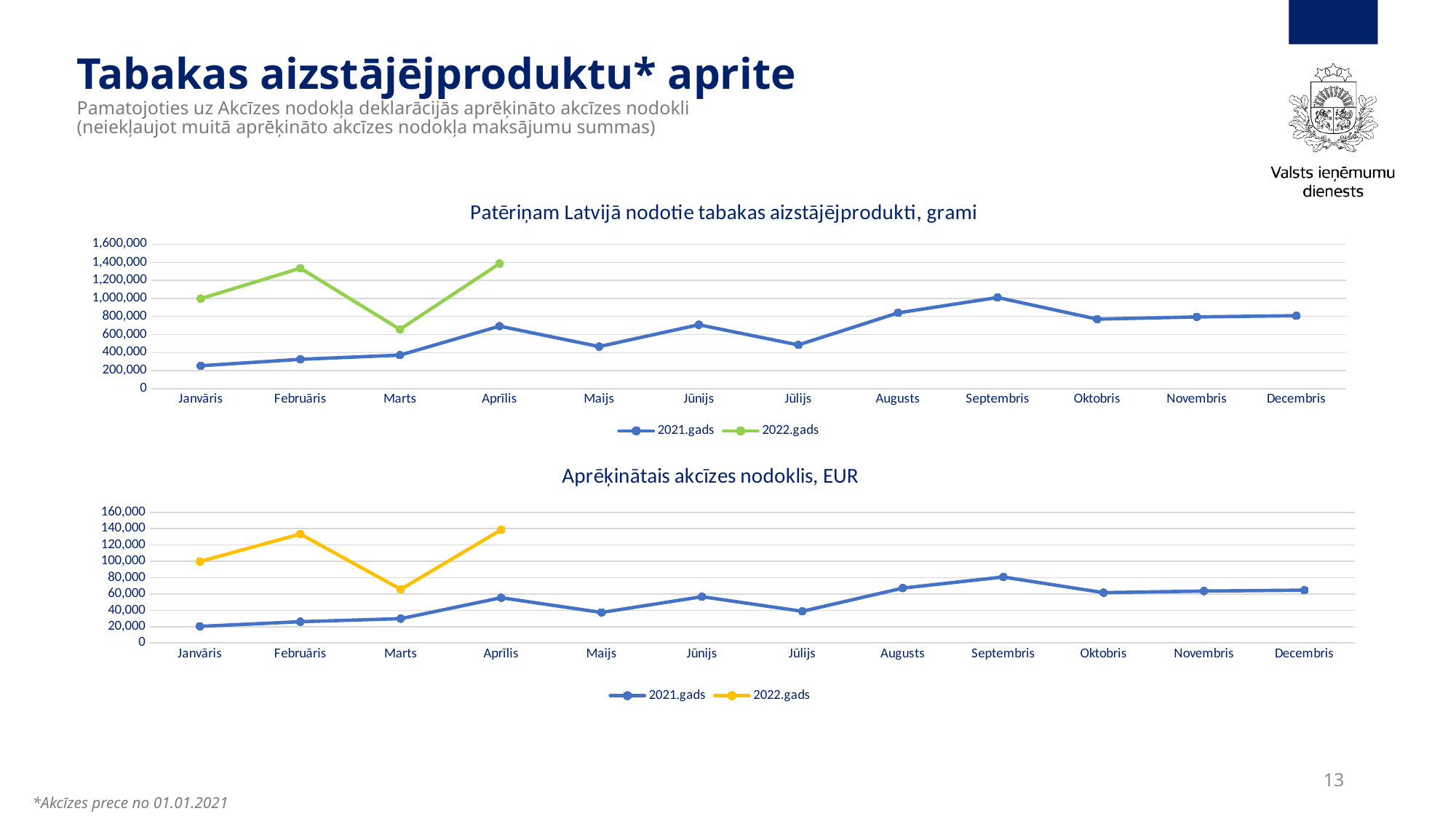
In the top chart (grami), does the 2021.gads line rise or fall from Janvāris to Aprīlis? Rise In the bottom chart (EUR), is the value for 2022.gads in Marts greater or less than 80,000? less In the top chart (grami), which series has the larger value in Aprīlis, 2021.gads or 2022.gads? 2022.gads In the top chart (grami), is the value for 2022.gads in Februāris greater or less than 1,200,000? greater In the bottom chart titled "Aprēķinātais akcīzes nodoklis, EUR", which month has the highest value for 2021.gads? Septembris What kind of chart is the top chart titled "Patēriņam Latvijā nodotie tabakas aizstājējprodukti, grami"? Line chart In the bottom chart (EUR), what colour is the line for 2022.gads? Yellow In the bottom chart (EUR), which month has the lowest value for 2021.gads? Janvāris In the top chart (grami), which month has the lowest value for 2021.gads? Janvāris In the top chart (grami), which month has the highest value for 2021.gads? Septembris In the top chart (grami), how many series does the legend list? 2 In the top chart (grami), how many months are shown on the x axis? 12